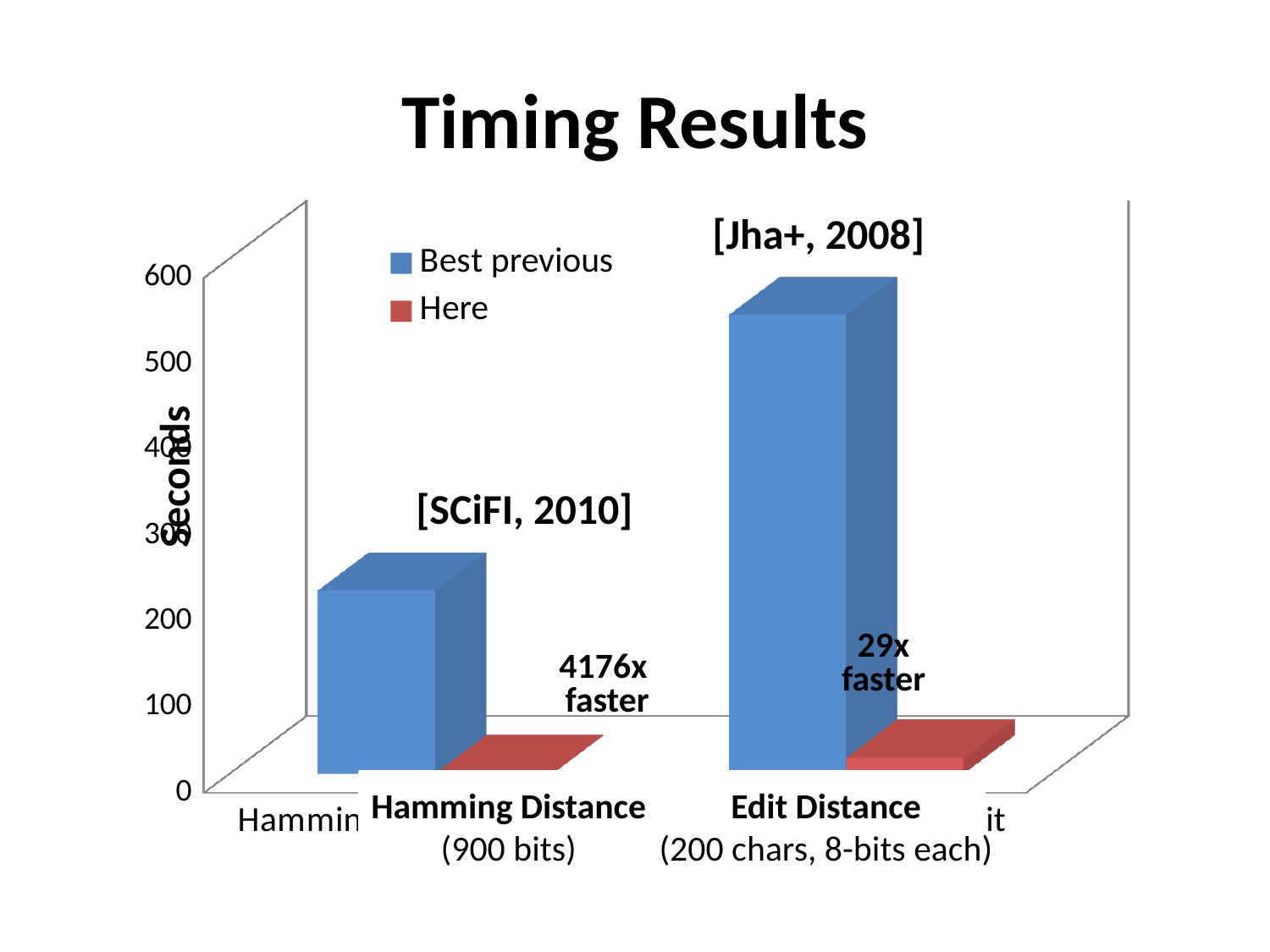
How many categories are shown on the x axis? 2 What is the title of the chart? Timing Results Is the Here value for Edit Distance greater or less than 100? less What kind of chart is shown on the slide? bar chart For Hamming Distance, which series has the larger value, Best previous or Here? Best previous What are the two legend entries? Best previous, Here Which is larger: the Best previous value for Hamming Distance or for Edit Distance? Edit Distance How many series does the legend list? 2 Is the Best previous value for Hamming Distance greater or less than 100? greater Is the Best previous value for Hamming Distance greater or less than 300? less Which category has the highest Best previous value? Edit Distance